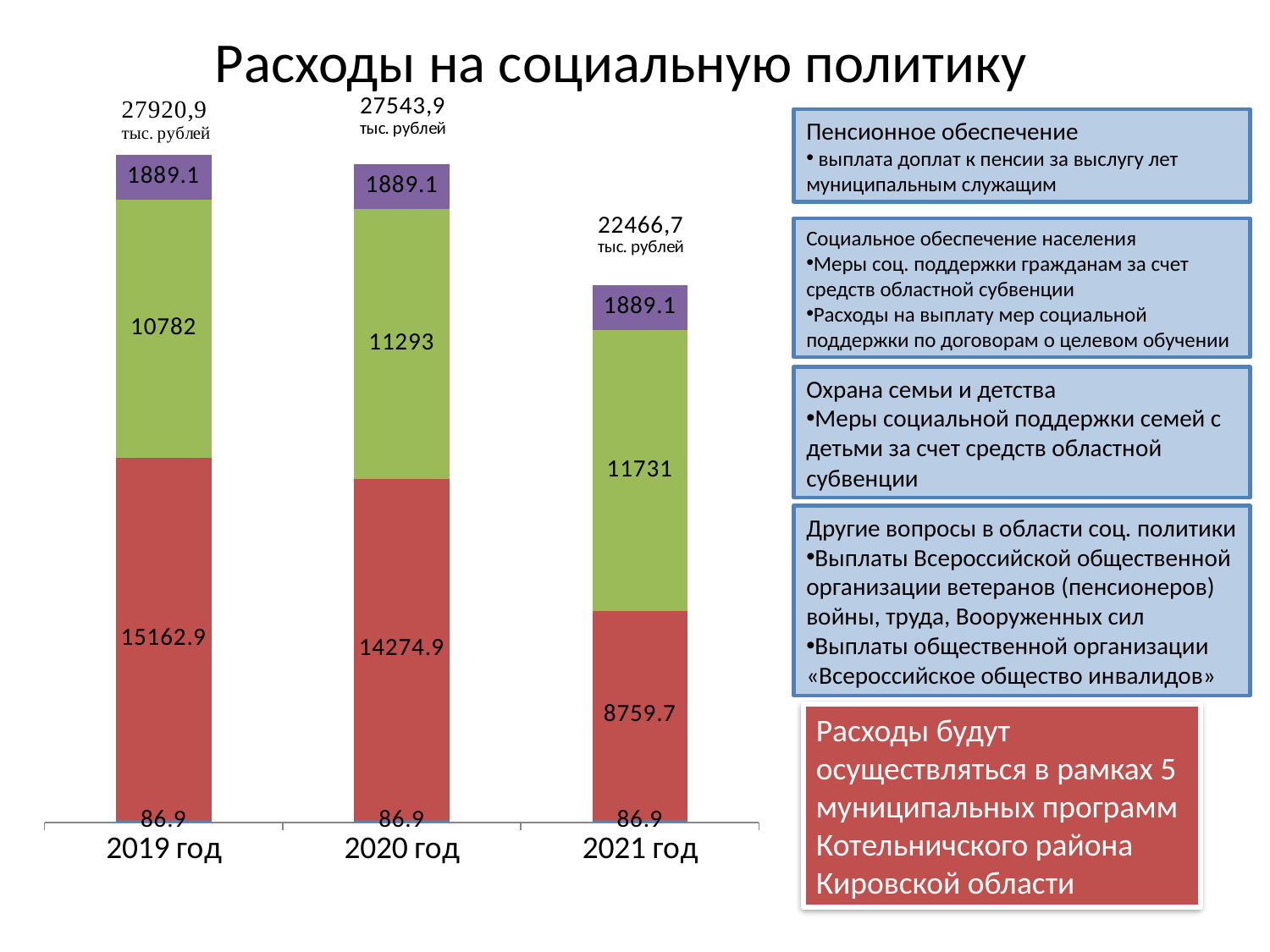
What kind of chart is shown on the slide? stacked bar chart What is the total printed above the bar for 2021 год? 22466,7 тыс. рублей Do the values of the red segment rise or fall from 2019 год to 2021 год? fall What is the value of the red segment of the bar for 2019 год? 15162.9 Which year has the highest total expenditure? 2019 год How many years (categories) are shown on the x axis of the chart? 3 What is the value of the green segment of the bar for 2021 год? 11731 What is the difference between the red segment values for 2019 год and 2021 год? 6403.2 Which year has the lowest total expenditure? 2021 год What is the title of the chart on the slide? Расходы на социальную политику What is the value of the purple segment of the bar for 2020 год? 1889.1 Which year has the larger green segment value, 2019 год or 2020 год? 2020 год